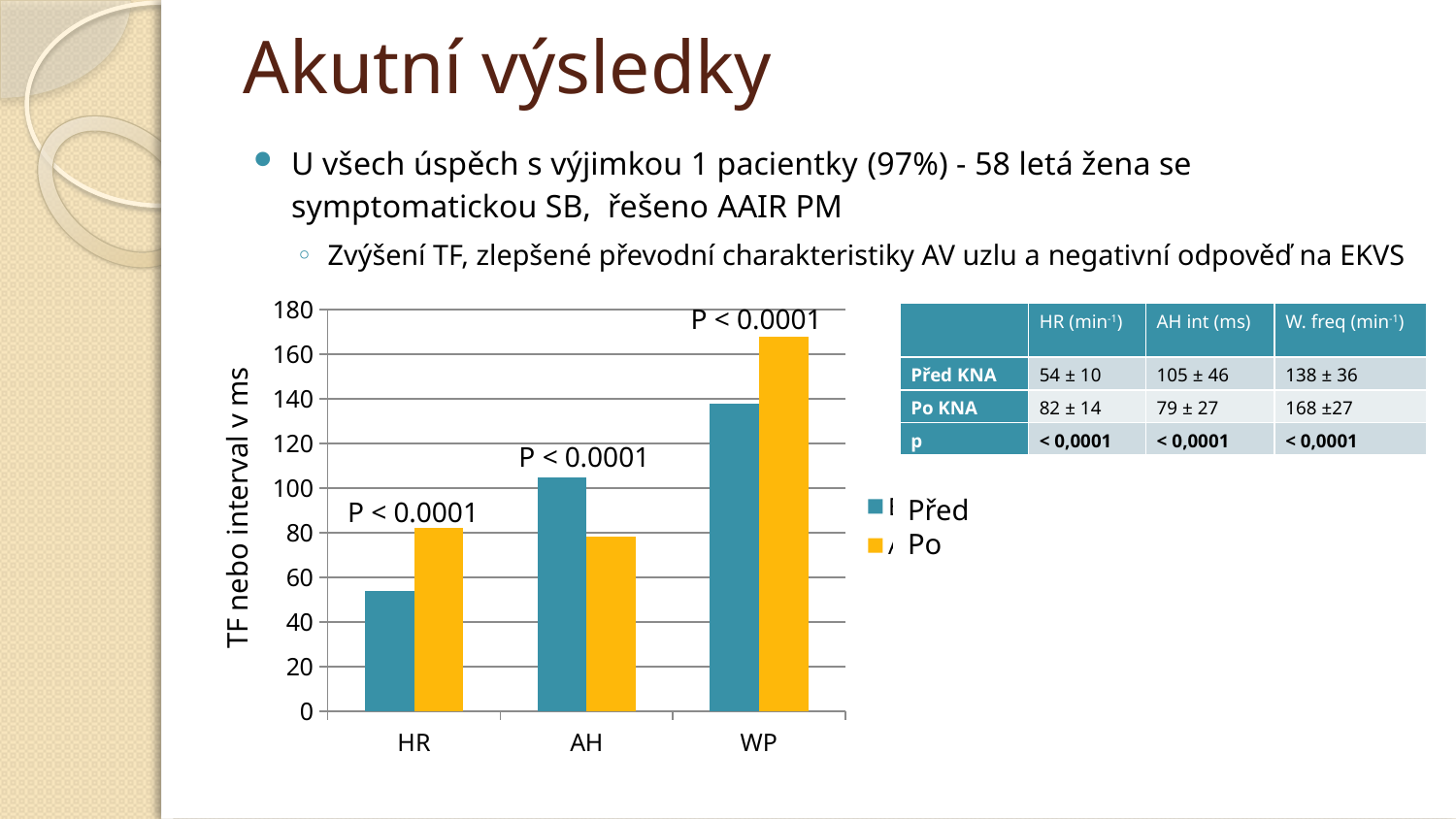
Which category has the highest Před bar? WP How many series does the chart legend list? 2 For AH, which is larger: the Před bar or the Po bar? Před Is the Po value for WP greater or less than 160? greater Which category has the lowest Po bar? AH For HR, which is larger: the Před bar or the Po bar? Po Is the Před value for AH greater or less than 100? greater Is the Po value for AH greater or less than 100? less What is the title of the vertical axis of the chart? TF nebo interval v ms What kind of chart is shown on the slide? bar chart How many categories are shown on the x axis of the chart? 3